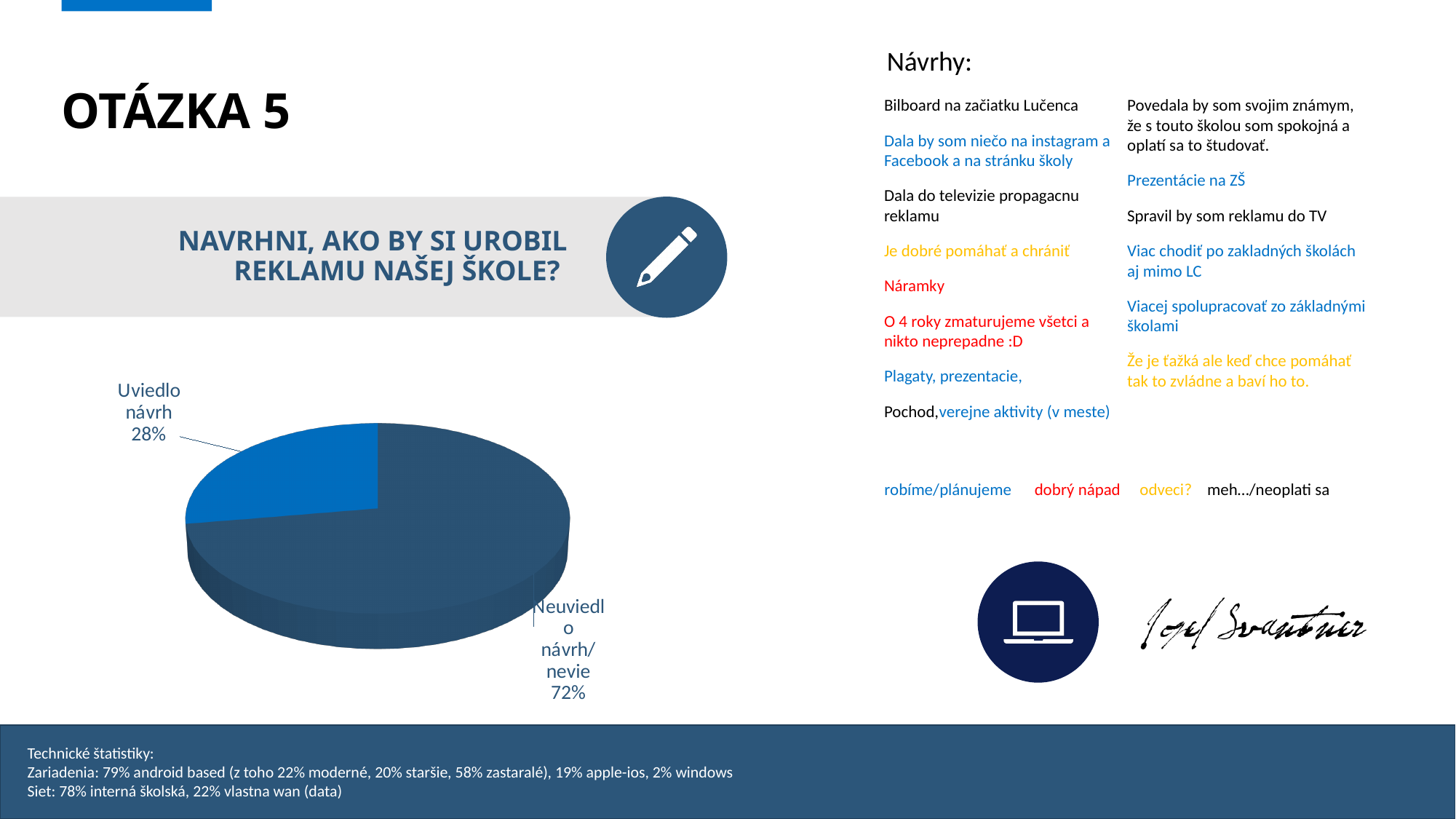
What share of the pie does "Neuviedlo návrh/nevie" represent? 72% What colour is the "Uviedlo návrh" slice of the pie chart? light blue What share of the pie does "Uviedlo návrh" represent? 28% Is the share for "Neuviedlo návrh/nevie" greater or less than 50%? greater Which slice of the pie chart is the largest? Neuviedlo návrh/nevie How many slices does the pie chart have? 2 Which is larger: the "Uviedlo návrh" slice or the "Neuviedlo návrh/nevie" slice? Neuviedlo návrh/nevie What is the difference in percentage points between the "Neuviedlo návrh/nevie" slice and the "Uviedlo návrh" slice? 44 What kind of chart is shown on the slide? pie chart What question does the pie chart on the slide relate to, as shown in the grey banner? NAVRHNI, AKO BY SI UROBIL REKLAMU NAŠEJ ŠKOLE? Is the share for "Uviedlo návrh" greater or less than 50%? less Which slice of the pie chart is the smallest? Uviedlo návrh